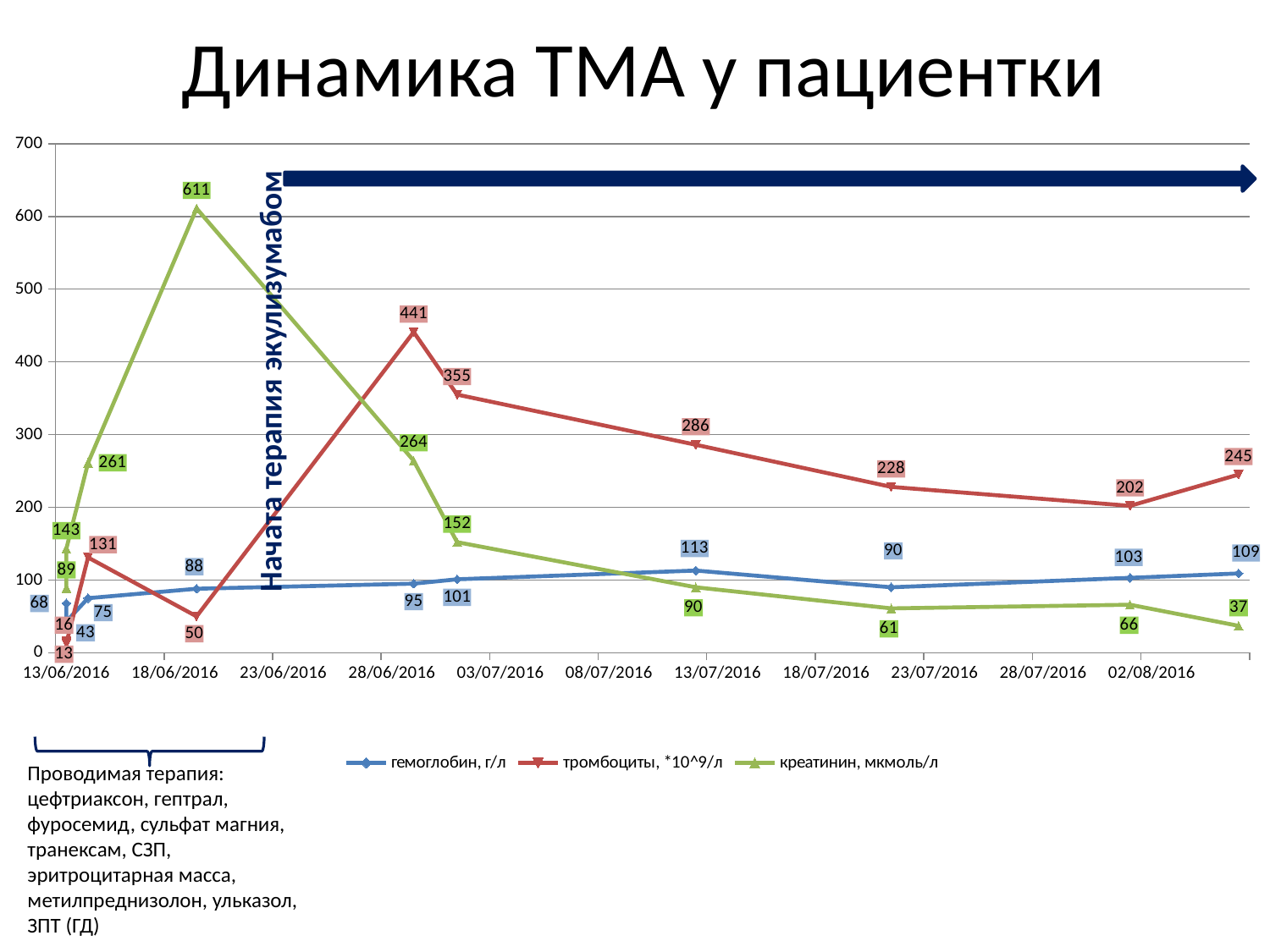
What is the difference between the peak platelet value (441) and the next platelet value (355)? 86 What is the highest value of the гемоглобин, г/л series? 113 Is the peak value of the креатинин series greater or less than 600? greater At the last data point, which is larger: the тромбоциты value or the гемоглобин value? тромбоциты What type of chart is shown on the slide? line chart What is the lowest value of the креатинин, мкмоль/л series? 37 What is the lowest value of the тромбоциты, *10^9/л series? 13 How many series does the legend list? 3 What is the highest value reached by the креатинин, мкмоль/л series? 611 What is the title of the chart? Динамика ТМА у пациентки After its peak of 611, does the креатинин series generally rise or fall along the x axis? fall What is the highest value of the тромбоциты, *10^9/л series? 441